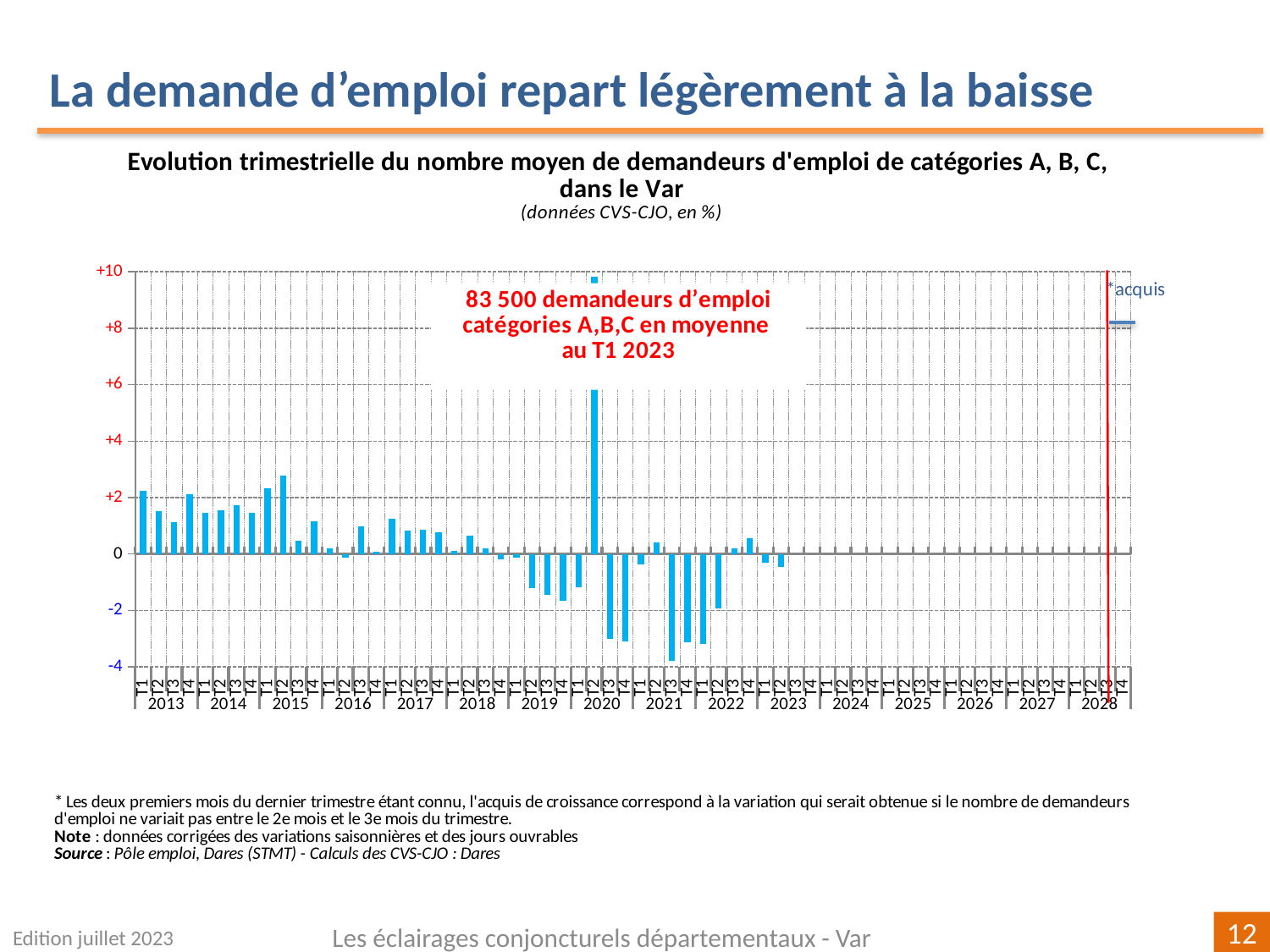
Is the value for T2 2015 greater or less than +2? greater Is the value for T3 2021 greater or less than -2? less What kind of chart is shown on the slide? bar chart Which is larger, the value for T2 2015 or the value for T1 2016? T2 2015 Which quarter has the highest value on the chart? T2 2020 Is the value for T4 2020 greater or less than -2? less Which is larger, the value for T2 2020 or the value for T3 2021? T2 2020 Do the bars for the quarters of 2021 lie mostly above or below zero? below How many years are labelled along the x axis of the chart? 16 Which quarter has the lowest value on the chart? T3 2021 According to the annotation on the chart, how many job seekers in categories A, B, C were there on average in T1 2023? 83 500